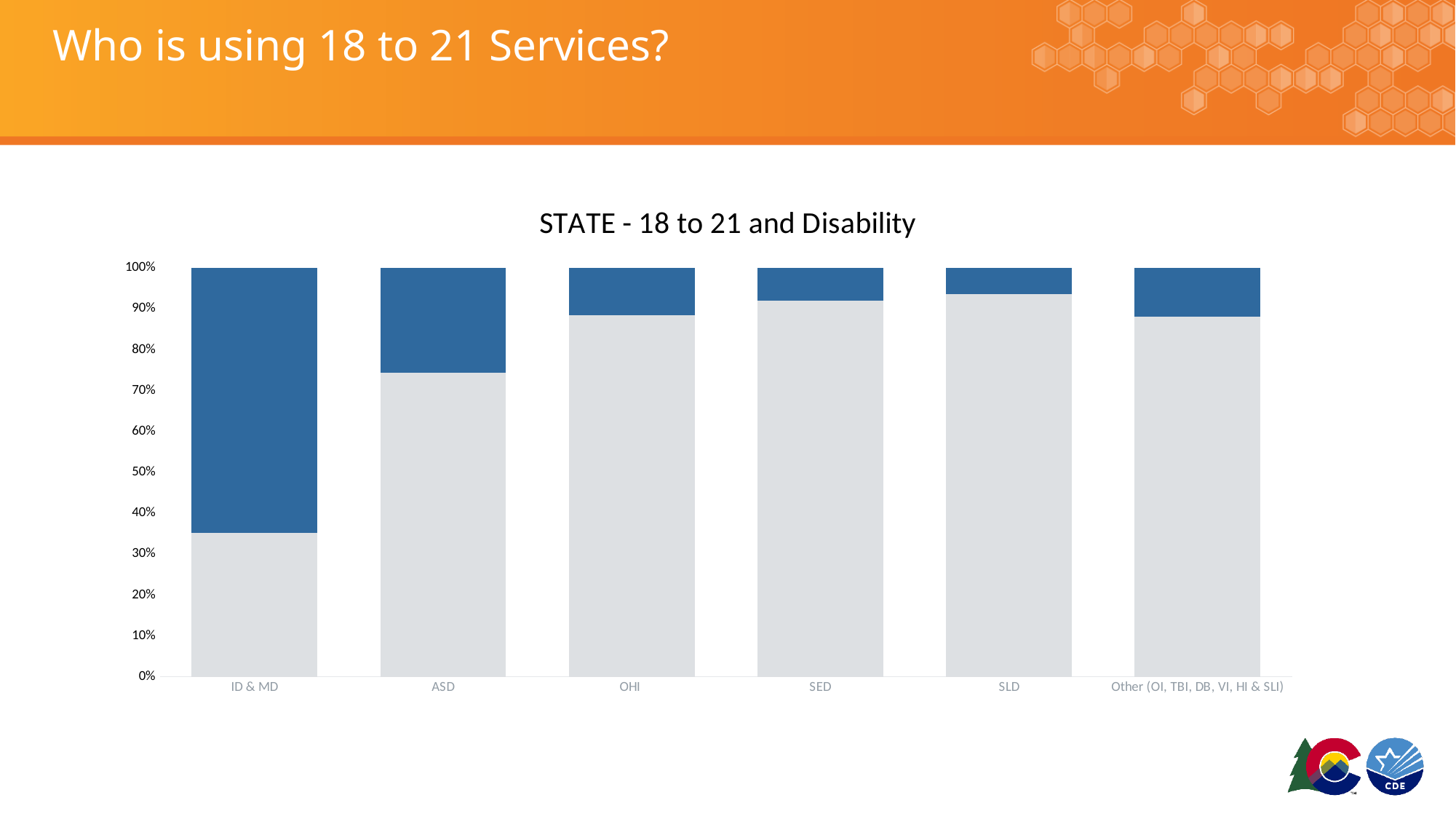
Is the grey (lower) segment for ASD greater or less than 70%? greater Which has the larger blue (upper) segment, ASD or SLD? ASD Which has the larger grey (lower) segment, ASD or OHI? OHI Is the grey (lower) segment for OHI greater or less than 90%? less Is the grey (lower) segment for ID & MD greater or less than 40%? less Which category has the smallest grey (lower) segment in the chart? ID & MD How many disability categories are shown on the x axis of the chart? 6 What is the title of the chart? STATE - 18 to 21 and Disability Which category has the largest blue (upper) segment in the chart? ID & MD What kind of chart is shown on the slide? Stacked bar chart